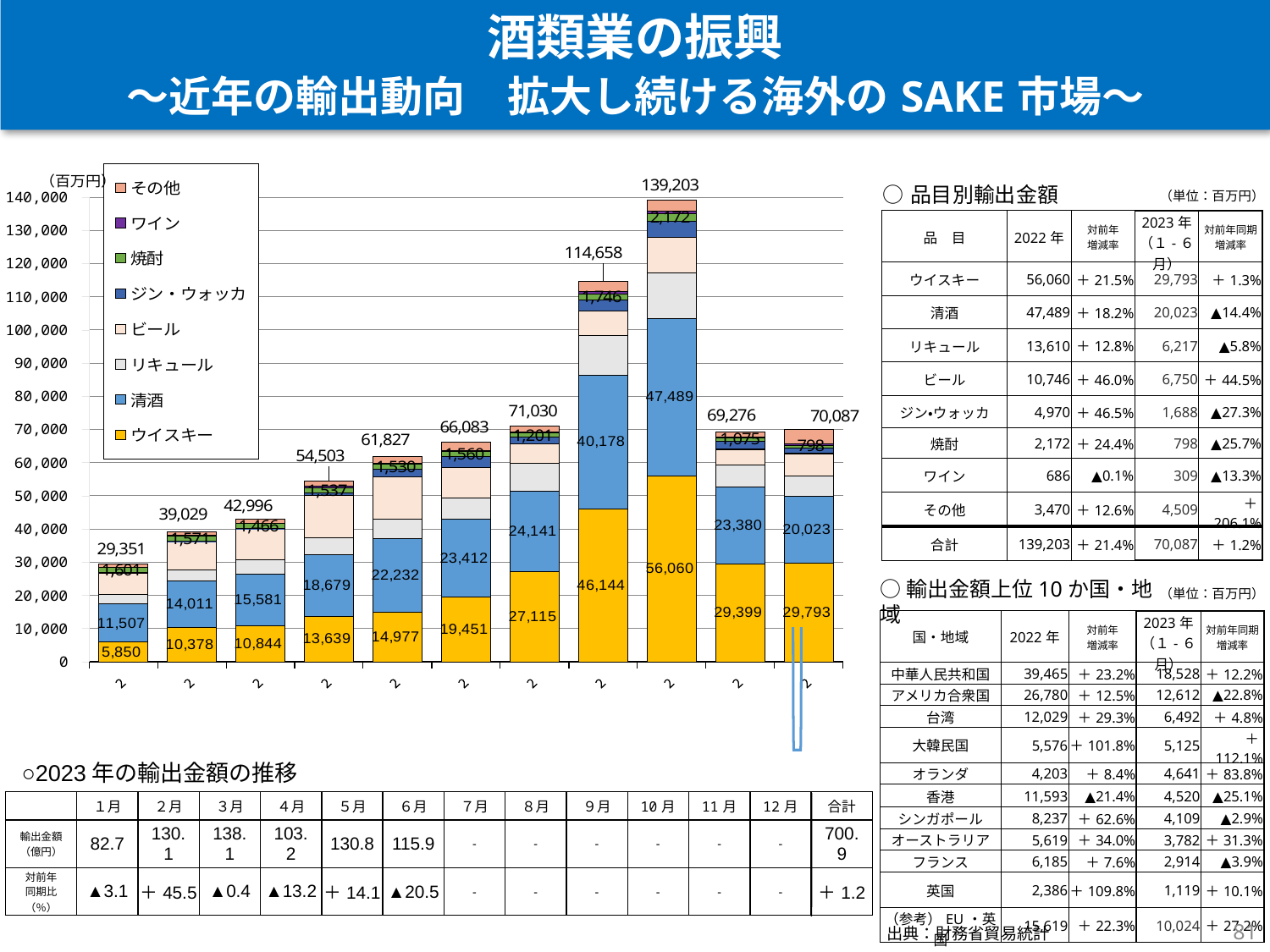
In the bar chart, what is the difference between the totals of the tallest bar (139,203) and the second-tallest bar (114,658)? 24,545 In the bar chart, which is larger: the ウイスキー value in the rightmost bar (29,793) or the 清酒 value in the rightmost bar (20,023)? ウイスキー (29,793) What unit is shown at the top of the y axis of the bar chart? 百万円 What is the total value printed above the leftmost (first) bar in the bar chart? 29,351 What is the total value printed above the rightmost (last) bar in the bar chart? 70,087 How many series does the legend of the bar chart list? 8 How many bars are plotted in the bar chart? 11 What kind of chart is shown on the left of the slide? stacked bar chart What is the total value printed above the tallest bar in the bar chart? 139,203 In the bar chart, what is the 清酒 (sake) value in the rightmost bar? 20,023 In the bar chart, what is the ウイスキー (whisky) value in the tallest bar? 56,060 Is the total of the second bar from the right in the bar chart greater or less than 60,000? greater